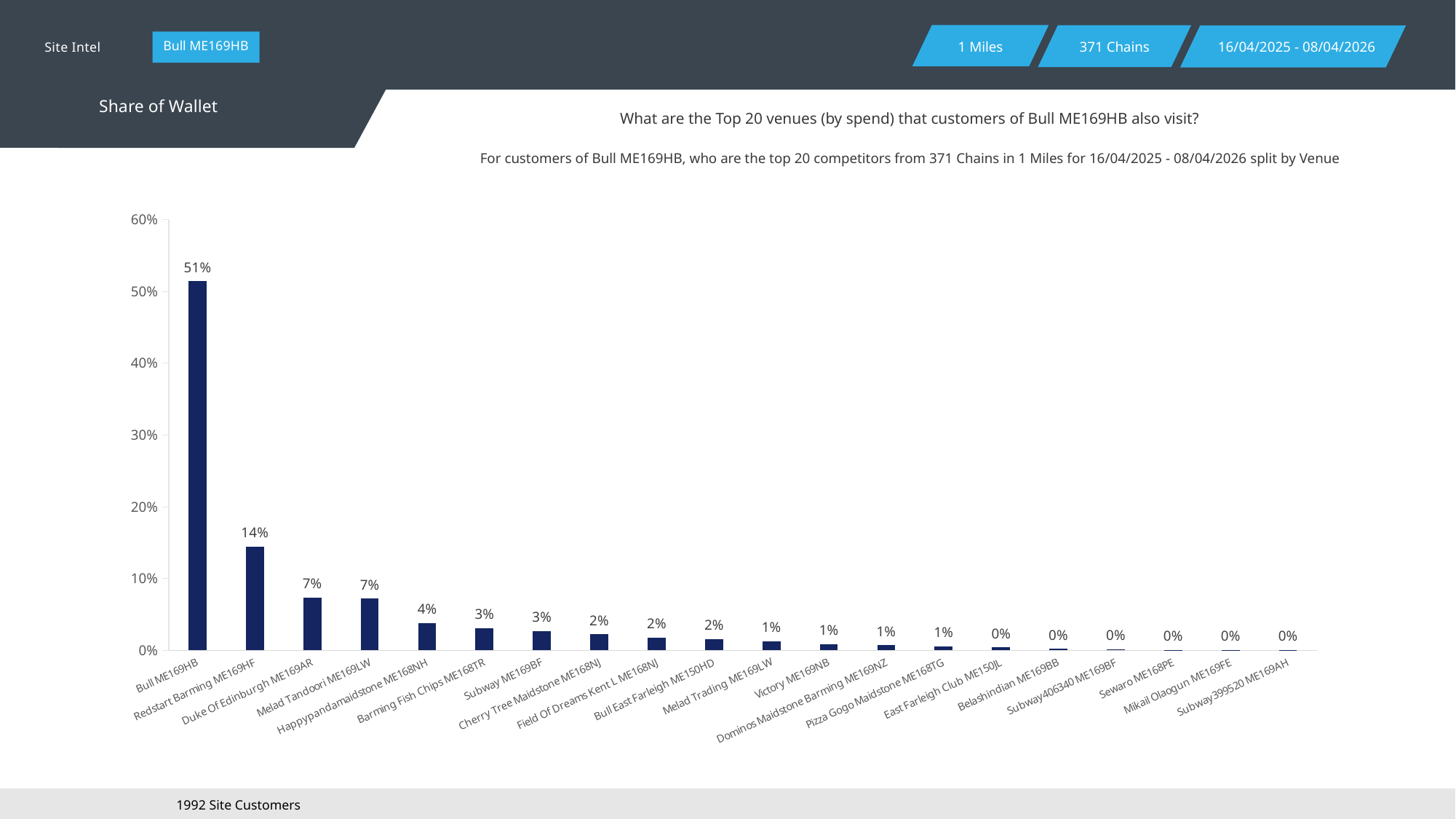
What is the value for Pizza Gogo Maidstone ME168TG? 1% Which is larger, the value for Redstart Barming ME169HF or Duke Of Edinburgh ME169AR? Redstart Barming ME169HF Is the value for Bull ME169HB greater or less than 50%? greater What is the value for Bull East Farleigh ME150HD? 2% What is the difference between the values for Bull ME169HB and Redstart Barming ME169HF? 37 percentage points How many venues are shown on the chart? 20 What is the value for Redstart Barming ME169HF? 14% What is the value for Happypandamaidstone ME168NH? 4% What kind of chart is shown on the slide? Bar chart Which venue has the highest share of wallet? Bull ME169HB Do the values rise or fall from left to right along the x axis? Fall What is the value for Bull ME169HB? 51%